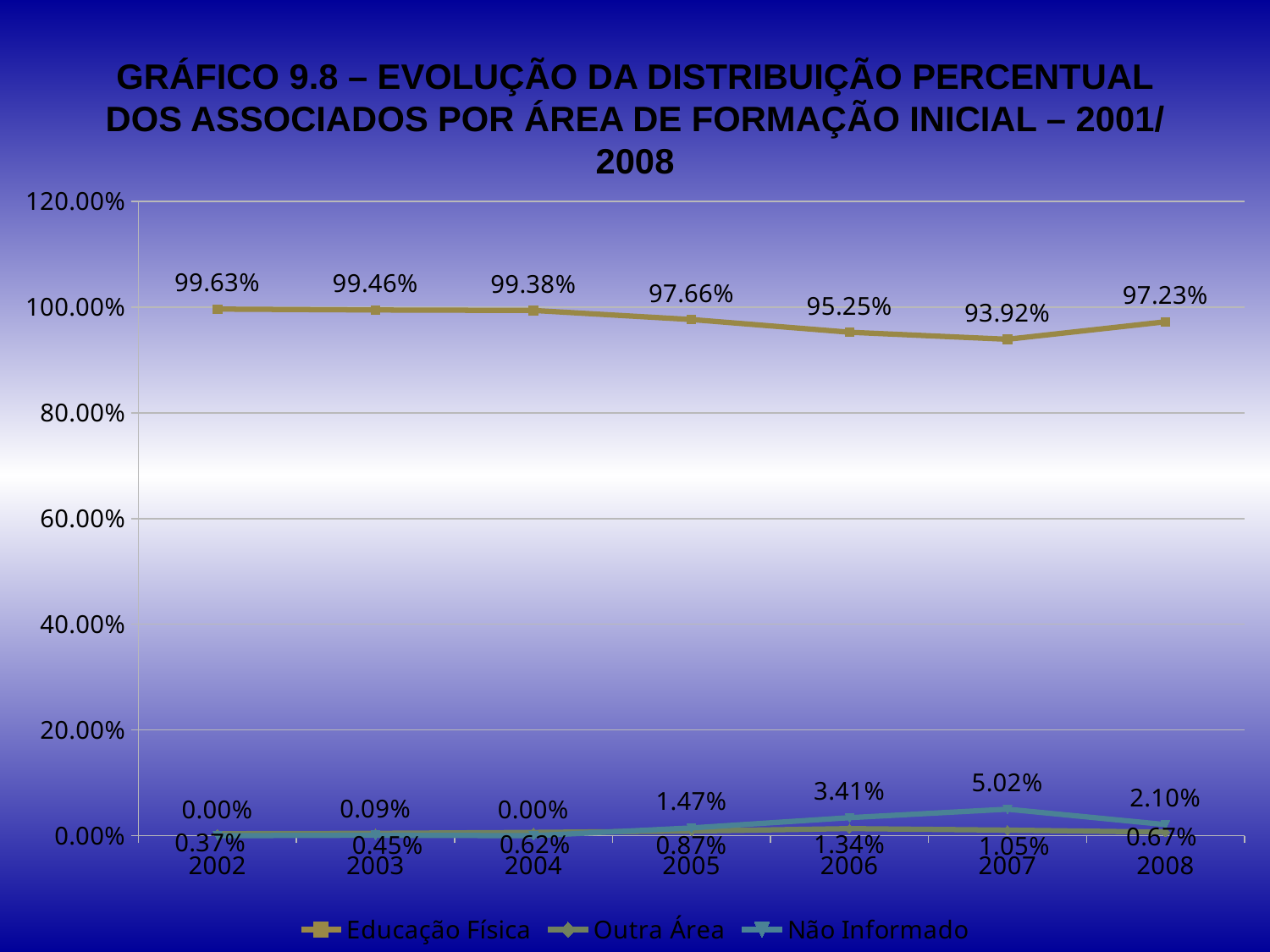
Which is larger, the Educação Física value in 2005 or in 2006? 2005 Which series is shown in teal in the legend? Não Informado How many series does the legend list? 3 What is the value for Educação Física in 2007? 93.92% Does the Educação Física line rise or fall from 2002 to 2007? fall What is the value for Educação Física in 2008? 97.23% How many years are plotted along the x axis? 7 What is the difference between the Educação Física values in 2002 and 2007? 5.71% What type of chart is shown on the slide? line chart In which year is the Educação Física value highest? 2002 In which year is the Educação Física value lowest? 2007 What is the value for Educação Física in 2002? 99.63%